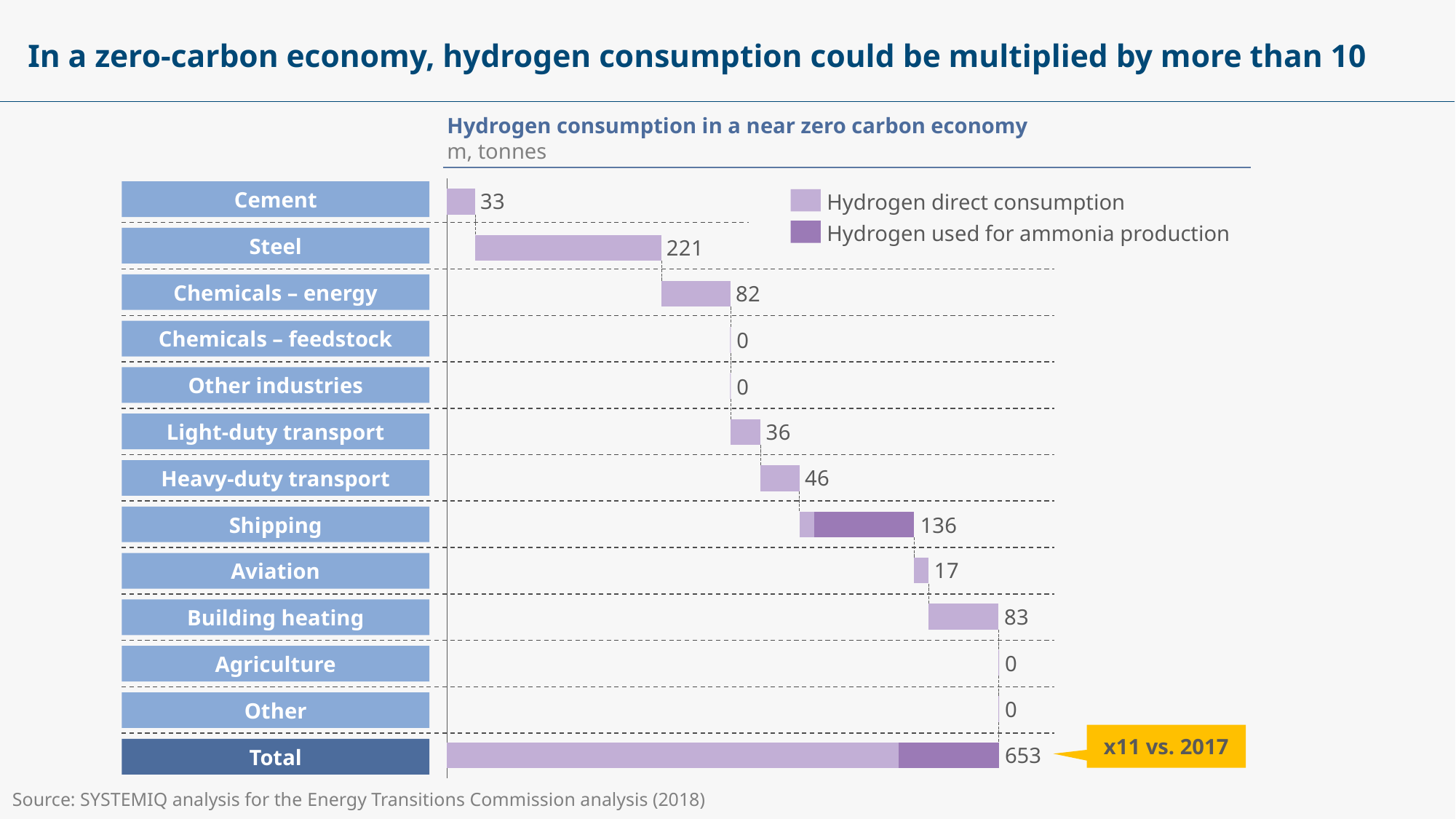
How many sectors (excluding Total) are listed in the chart? 12 What is the Total hydrogen consumption shown in the chart? 653 What is the hydrogen consumption value for Shipping? 136 What is the hydrogen consumption value for Building heating? 83 What unit is the chart measured in? m, tonnes What is the hydrogen consumption value for Steel? 221 How many series does the legend list? 2 What kind of chart is shown on the slide? Bar chart (waterfall) Excluding the Total, which sector has the highest hydrogen consumption? Steel Which is larger, the value for Heavy-duty transport or Light-duty transport? Heavy-duty transport What does the yellow callout next to the Total bar say? x11 vs. 2017 What is the difference between the values for Steel and Chemicals – energy? 139